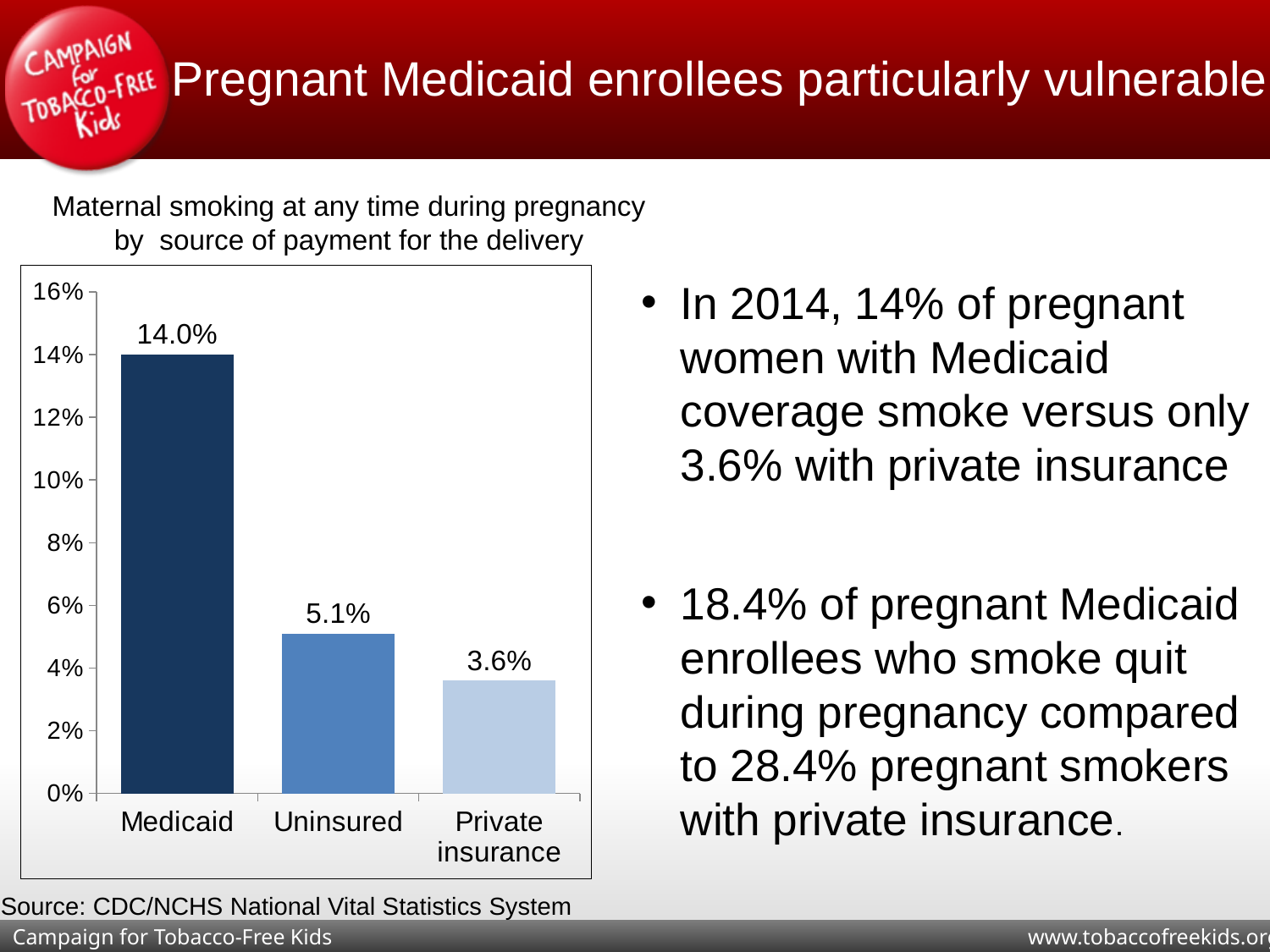
What is the difference between the values for Medicaid and Private insurance? 10.4% Which is larger, the value for Uninsured or the value for Private insurance? Uninsured What is the value for Private insurance? 3.6% What is the title of the chart? Maternal smoking at any time during pregnancy by source of payment for the delivery Is the value for Medicaid greater or less than 12%? greater How many categories are shown on the chart? 3 Which category has the lowest value? Private insurance What kind of chart is shown on the slide? bar chart What is the difference between the values for Uninsured and Private insurance? 1.5% What is the value for Medicaid? 14.0% Which category has the highest value? Medicaid What is the value for Uninsured? 5.1%